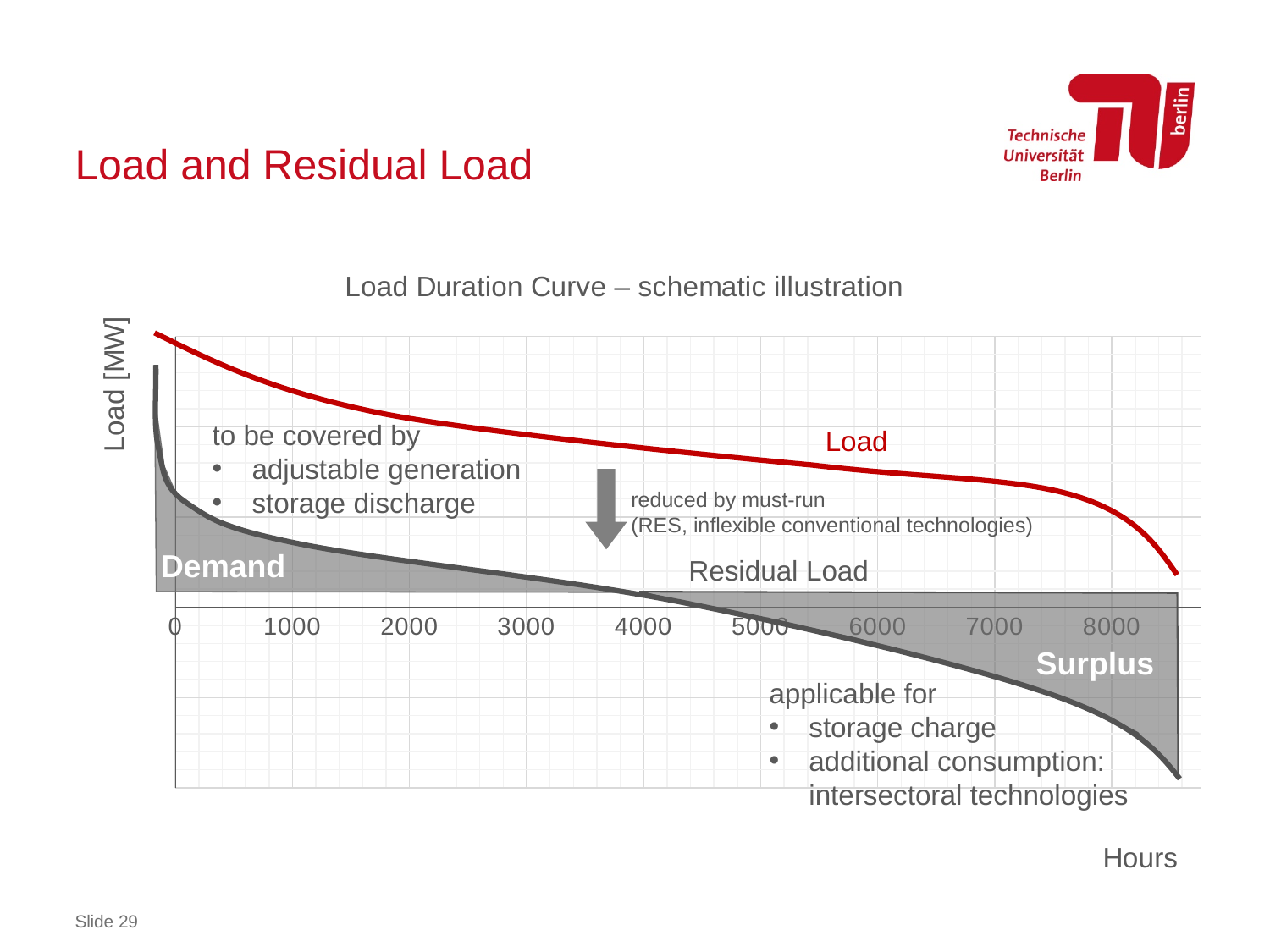
What is the shaded area below the zero line labelled? Surplus What is the highest tick value shown on the x axis? 8000 Is the Residual Load curve above or below zero at 7000 hours? below What is the title of the chart? Load Duration Curve – schematic illustration What kind of chart is shown on the slide? line chart How many curves are plotted on the chart? 2 Is the Residual Load curve above or below zero at 2000 hours? above Which curve lies higher on the chart, Load or Residual Load? Load Does the Residual Load curve rise or fall as hours increase along the x axis? fall Does the Load curve rise or fall as hours increase along the x axis? fall What is the shaded area above the zero line labelled? Demand What is the label of the x axis? Hours